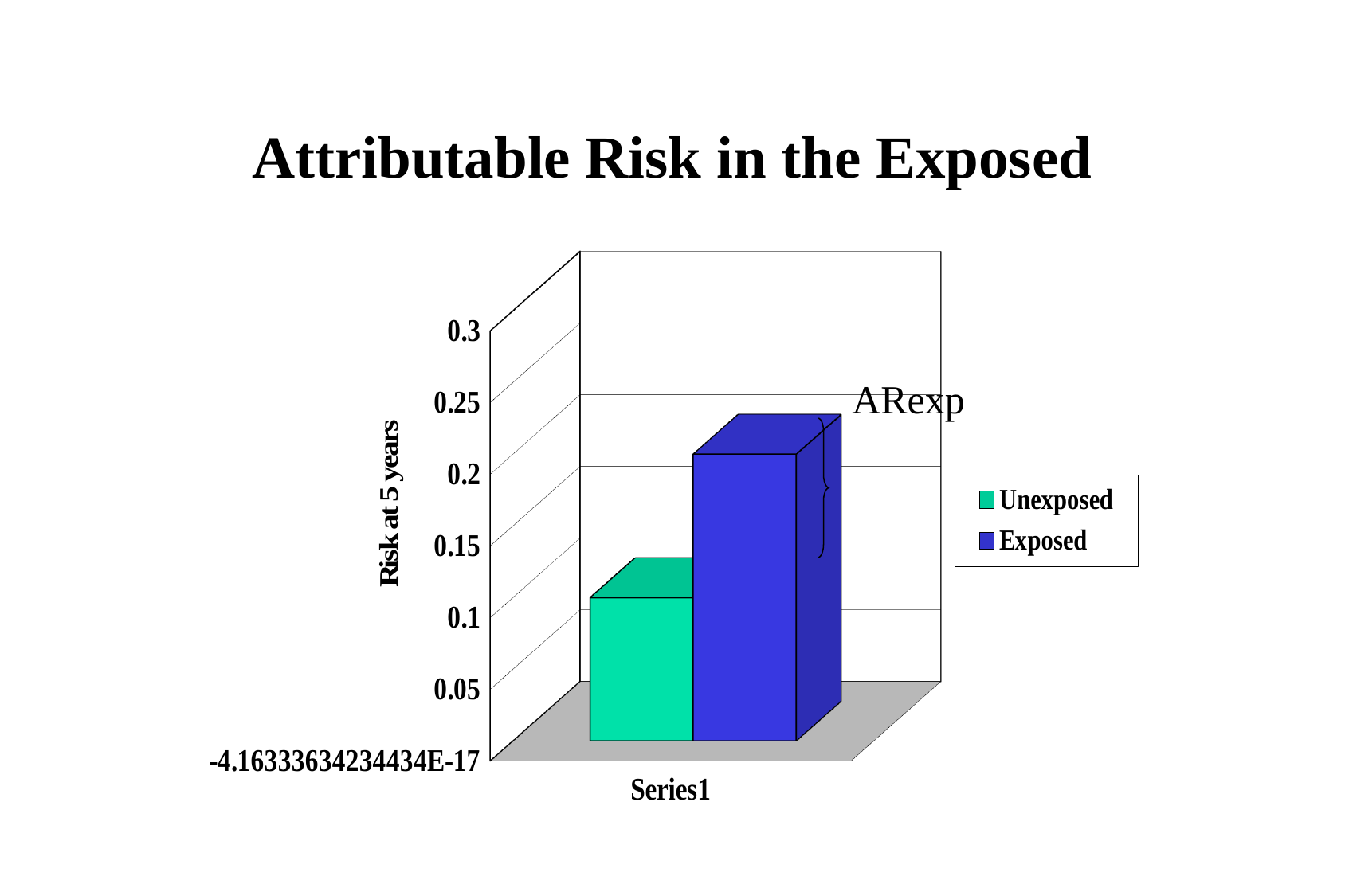
What is the title of the slide's chart? Attributable Risk in the Exposed How many bars are plotted in the chart? 2 Which group has the higher risk at 5 years, Unexposed or Exposed? Exposed Is the value for Unexposed greater or less than 0.05? greater Is the value for Unexposed greater or less than 0.15? less Which group has the lowest bar in the chart? Unexposed How many series does the legend list? 2 Is the value for Exposed greater or less than 0.25? less What is the label on the vertical axis of the chart? Risk at 5 years What kind of chart is shown on the slide? bar chart Which group has the highest bar in the chart? Exposed